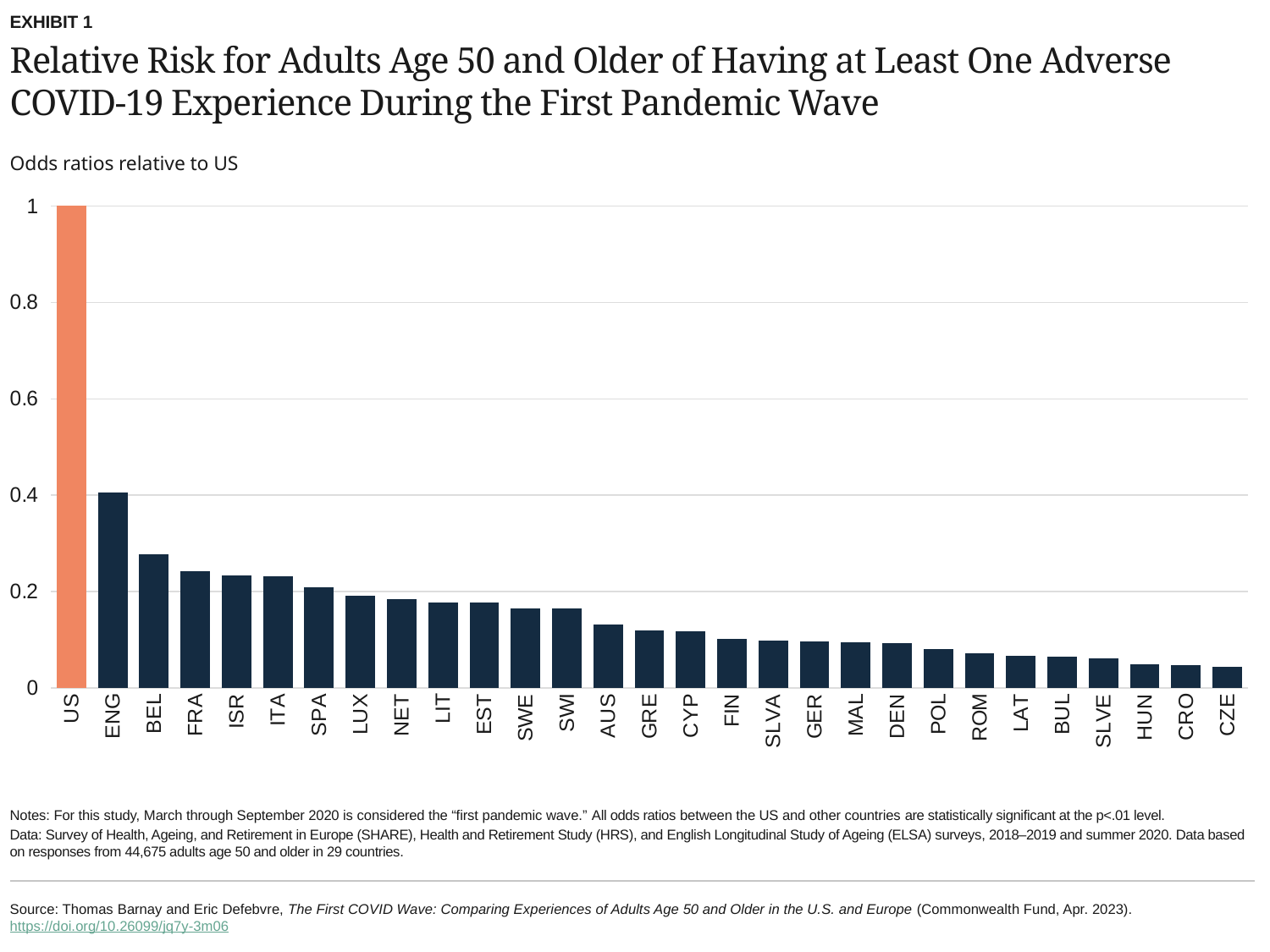
Which country has the lowest odds ratio in the chart? CZE What is the odds ratio value for the US? 1 Is the value for AUS greater or less than 0.2? less Do the values rise or fall moving from left to right along the x axis? Fall Which has a larger odds ratio, FRA or CZE? FRA What does the subtitle say the values are measured as? Odds ratios relative to US Which country has the highest odds ratio in the chart? US Which has a larger odds ratio, ENG or BEL? ENG Is the value for BEL greater or less than 0.2? greater What kind of chart is shown on the slide? Bar chart Is the value for BEL greater or less than 0.4? less How many countries are shown on the x axis of the chart? 29